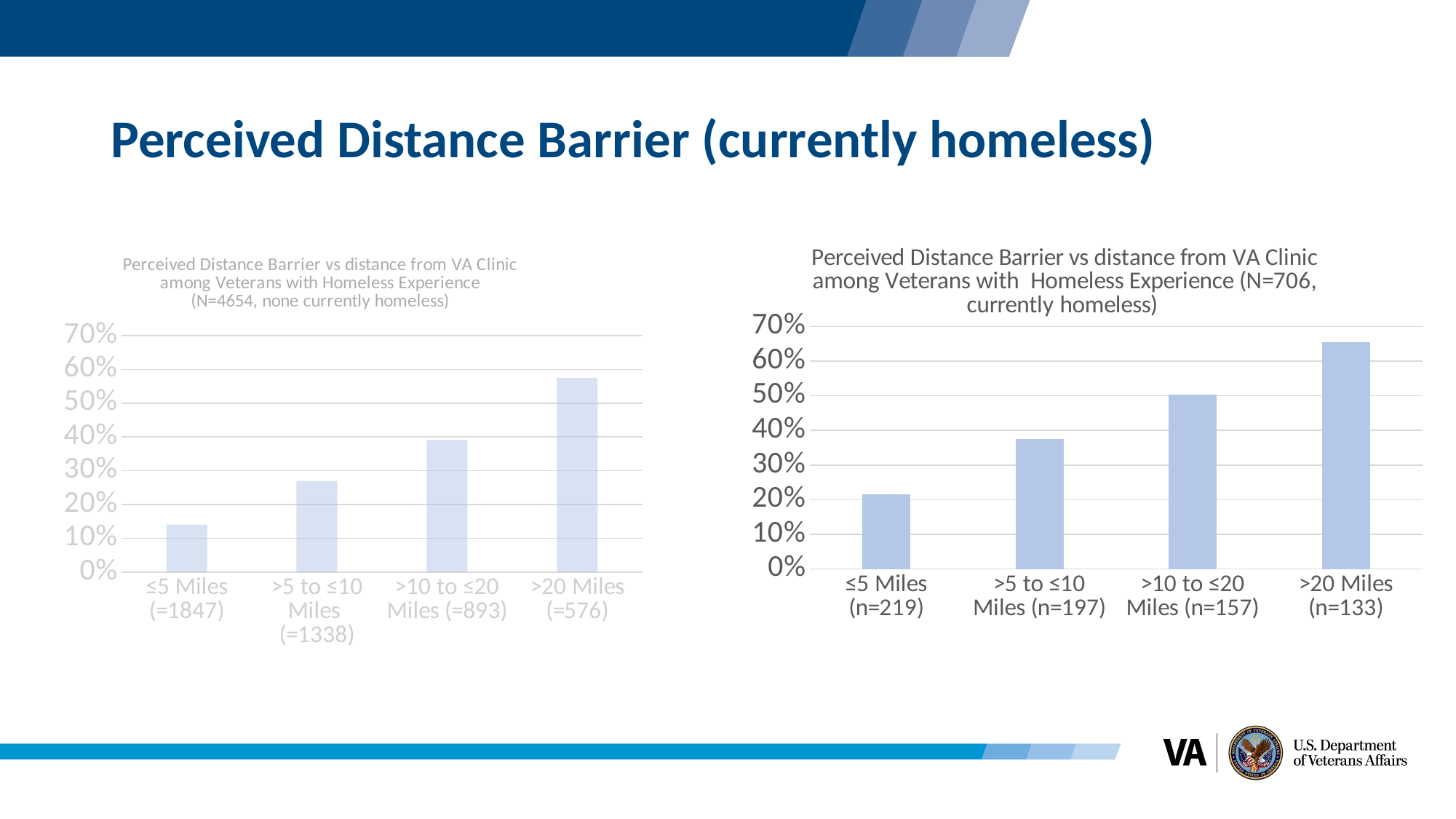
On the right chart (N=706, currently homeless), how many distance categories are shown? 4 What is the sample size (n) for the >10 to ≤20 Miles category on the right chart? n=157 What kind of chart is the right chart (N=706, currently homeless)? bar chart On the left chart (N=4654, none currently homeless), which is larger, the value for ≤5 Miles or the value for >5 to ≤10 Miles? >5 to ≤10 Miles On the right chart (N=706, currently homeless), is the value for >5 to ≤10 Miles greater or less than 30%? greater On the left chart (N=4654, none currently homeless), is the value for >20 Miles greater or less than 50%? greater On the right chart (N=706, currently homeless), do the values rise or fall as distance from the VA clinic increases? rise On the right chart (N=706, currently homeless), is the value for >20 Miles greater or less than 60%? greater On the right chart (N=706, currently homeless), which distance category has the highest perceived distance barrier? >20 Miles (n=133) On the right chart (N=706, currently homeless), which distance category has the lowest perceived distance barrier? ≤5 Miles (n=219) On the left chart (N=4654, none currently homeless), which distance category has the highest perceived distance barrier? >20 Miles (=576)